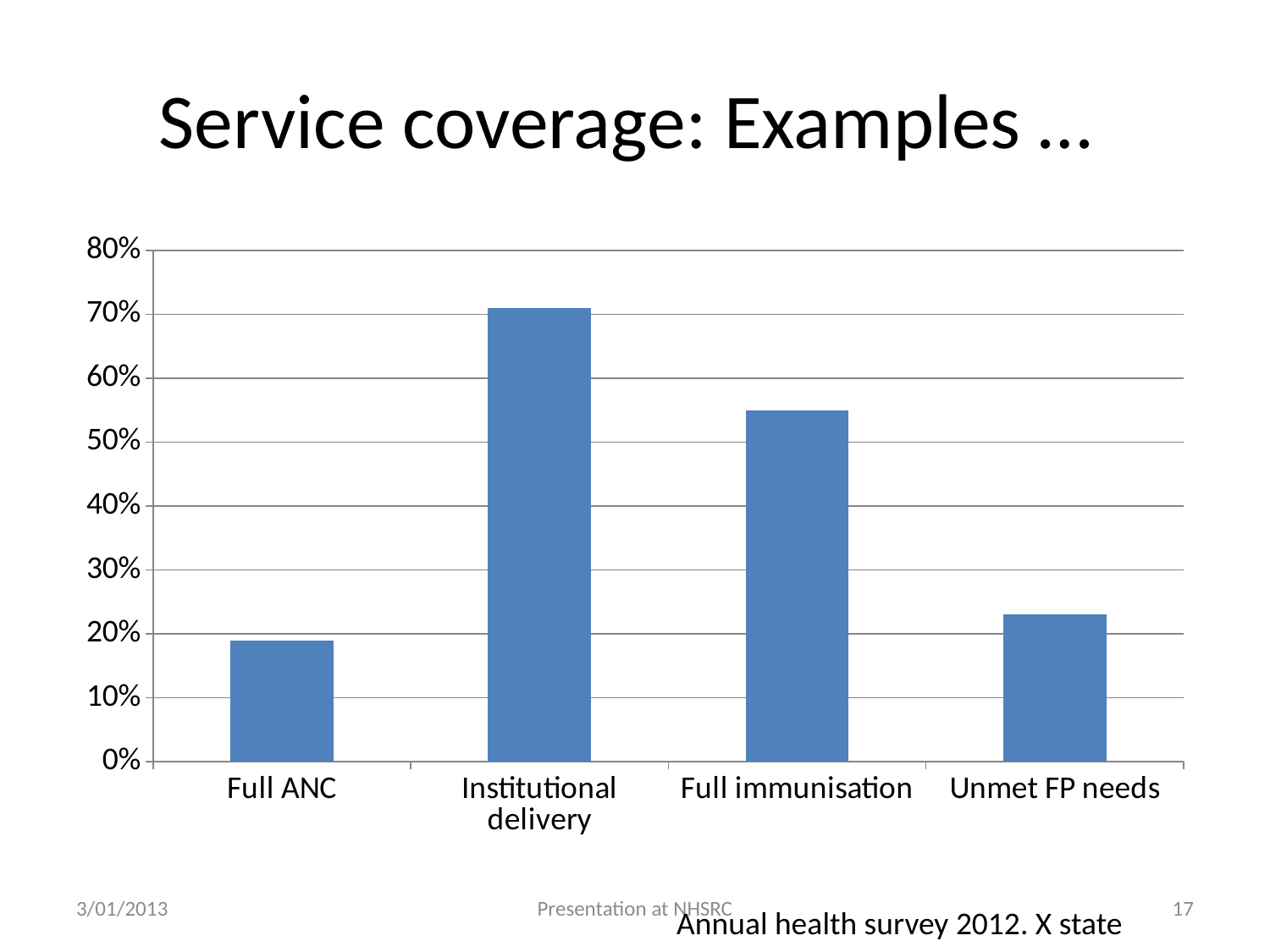
Is the value for Institutional delivery greater or less than 60%? greater How many categories are plotted on the chart? 4 Is the value for Full immunisation greater or less than 50%? greater Is the value for Unmet FP needs greater or less than 30%? less Which category has the lowest value? Full ANC Which is larger, the value for Institutional delivery or the value for Full immunisation? Institutional delivery Which is larger, the value for Full immunisation or the value for Unmet FP needs? Full immunisation Which category has the highest value? Institutional delivery What is the title of the slide containing the chart? Service coverage: Examples … What kind of chart is shown on the slide? bar chart What is the highest value shown on the vertical axis of the chart? 80%